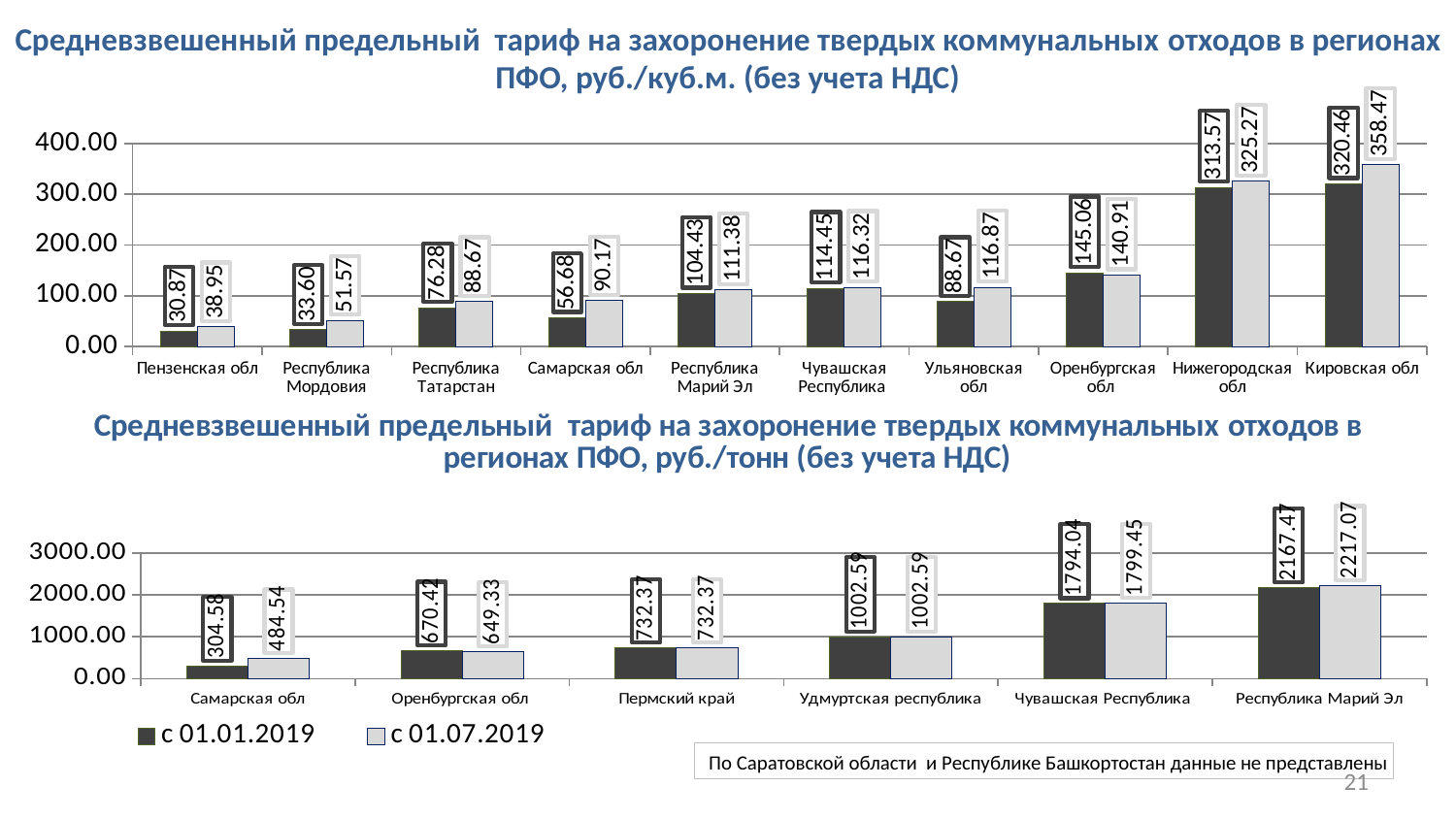
In the top chart (руб./куб.м.), how many regions are shown on the x axis? 10 How many series does the legend list? 2 In the bottom chart (руб./тонн), which is larger for Оренбургская обл: the с 01.01.2019 value or the с 01.07.2019 value? с 01.01.2019 In the bottom chart (руб./тонн), how many regions are shown on the x axis? 6 In the top chart (руб./куб.м.), what is the value for Самарская обл for the series с 01.01.2019? 56.68 In the top chart (руб./куб.м.), is the с 01.01.2019 value for Оренбургская обл greater or less than 100.00? greater In the top chart (руб./куб.м.), which region has the lowest value for the series с 01.01.2019? Пензенская обл In the top chart (руб./куб.м.), what is the value for Кировская обл for the series с 01.07.2019? 358.47 In the bottom chart (руб./тонн), what is the difference between the с 01.07.2019 and с 01.01.2019 values for Самарская обл? 179.96 In the top chart (руб./куб.м.), what is the difference between the с 01.07.2019 and с 01.01.2019 values for Нижегородская обл? 11.70 In the bottom chart (руб./тонн), what is the value for Республика Марий Эл for the series с 01.07.2019? 2217.07 In the top chart (руб./куб.м.), which region has the highest value for the series с 01.07.2019? Кировская обл